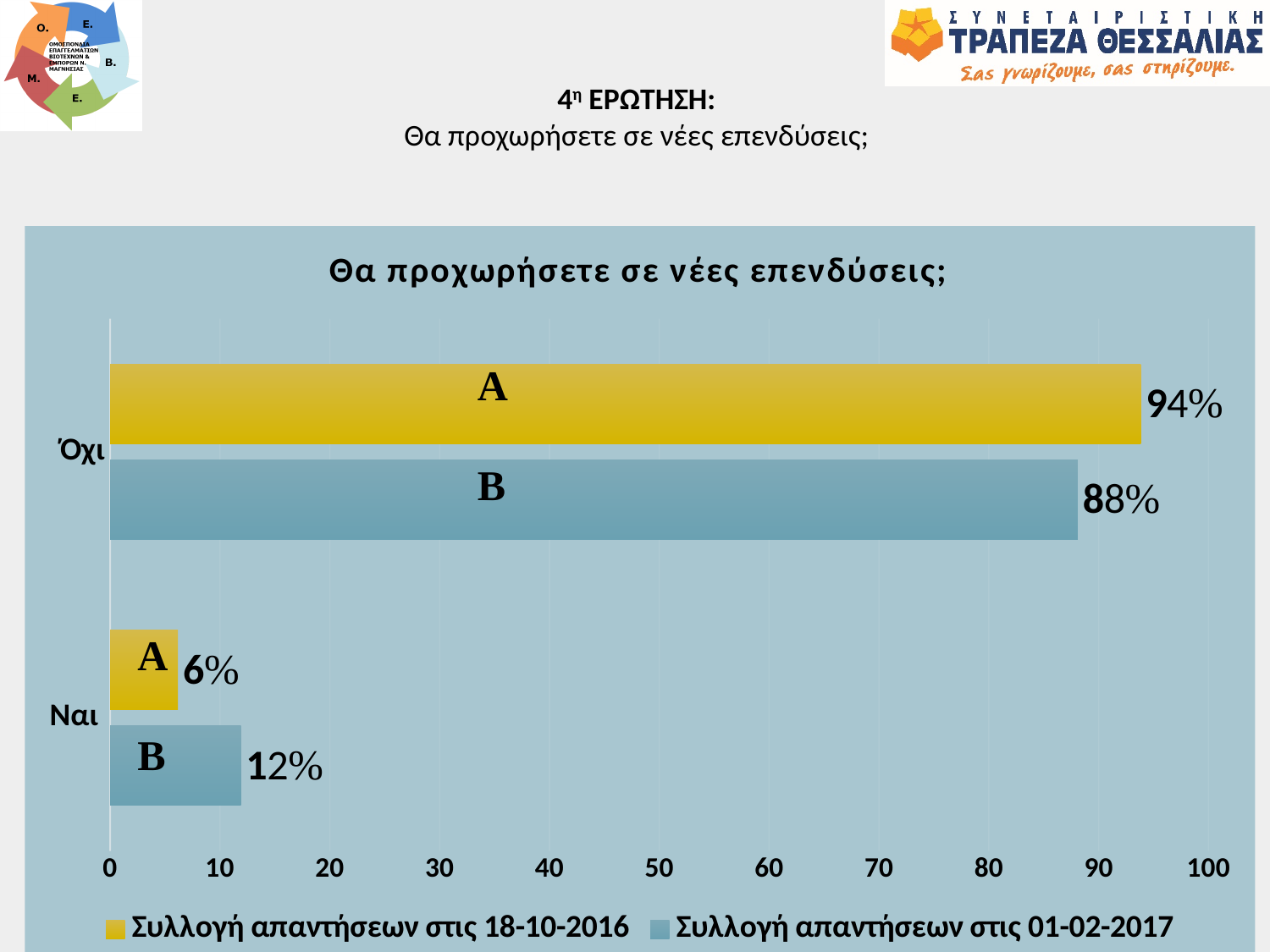
What is the difference between the Όχι values of the two series? 6% What is the difference between the Ναι values of the two series? 6% What is the value for Όχι in the series Συλλογή απαντήσεων στις 01-02-2017? 88% What is the value for Ναι in the series Συλλογή απαντήσεων στις 01-02-2017? 12% What is the value for Ναι in the series Συλλογή απαντήσεων στις 18-10-2016? 6% What kind of chart is shown on the slide? Bar chart What is the value for Όχι in the series Συλλογή απαντήσεων στις 18-10-2016? 94% How many series does the legend list? 2 Which category has the lowest value in the series Συλλογή απαντήσεων στις 01-02-2017? Ναι Which category has the highest value in the series Συλλογή απαντήσεων στις 18-10-2016? Όχι Which series has the larger value for Ναι? Συλλογή απαντήσεων στις 01-02-2017 How many categories are shown on the chart? 2